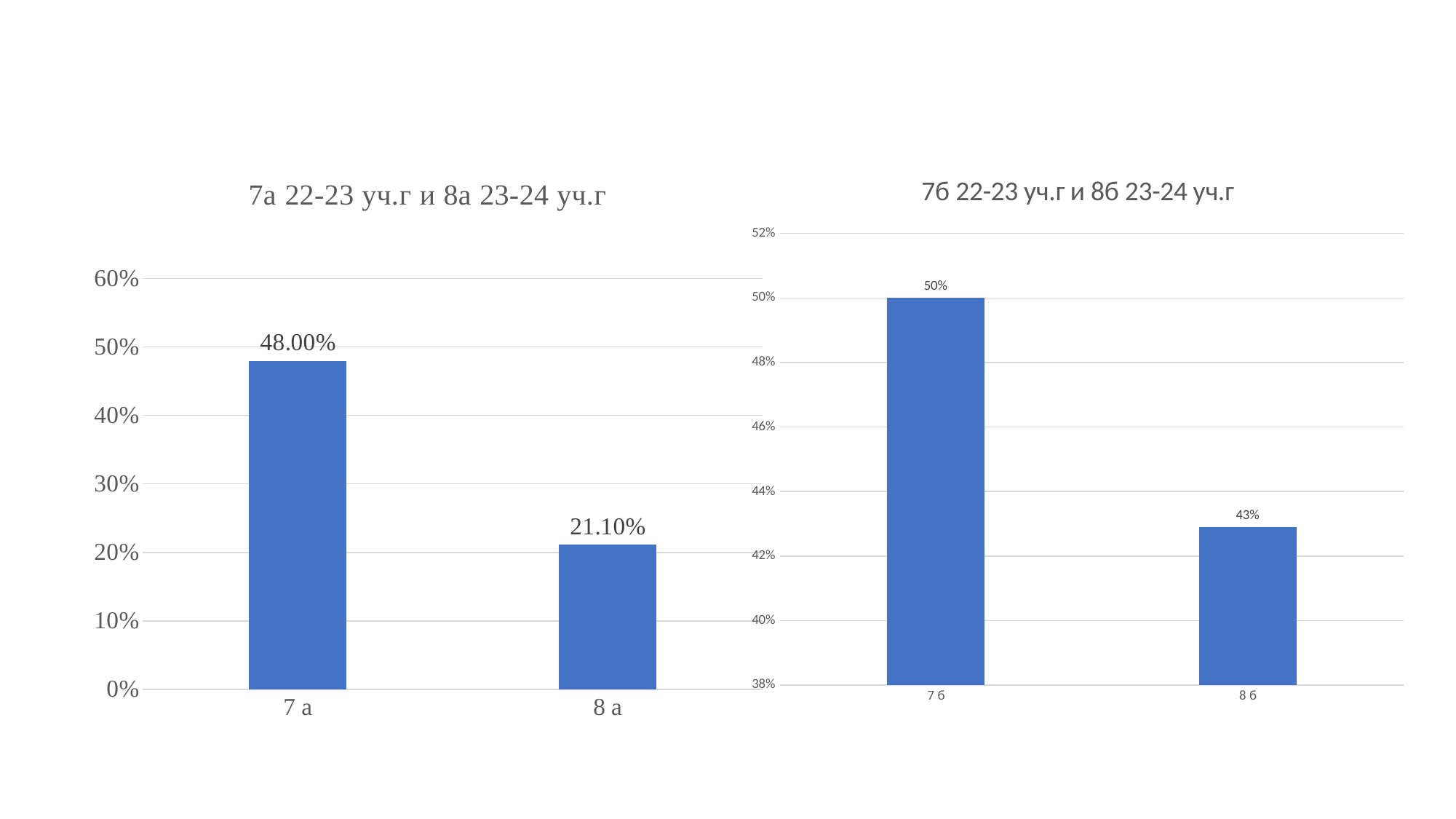
In the chart titled "7а 22-23 уч.г и 8а 23-24 уч.г", what is the value for 8 а? 21.10% In the left chart, what is the difference between the values for 7 а and 8 а? 26.90% In the chart titled "7б 22-23 уч.г и 8б 23-24 уч.г", what is the value for 8 б? 43% In the right chart, which category has the lowest value? 8 б In the left chart, which category has the highest value? 7 а In the chart titled "7б 22-23 уч.г и 8б 23-24 уч.г", what is the value for 7 б? 50% In the right chart, what is the difference between the values for 7 б and 8 б? 7% What is the title of the left chart? 7а 22-23 уч.г и 8а 23-24 уч.г How many categories are shown in the left chart? 2 In the chart titled "7а 22-23 уч.г и 8а 23-24 уч.г", what is the value for 7 а? 48.00% What kind of chart is the chart titled "7б 22-23 уч.г и 8б 23-24 уч.г"? Bar chart In the right chart, which is larger, the value for 7 б or the value for 8 б? 7 б